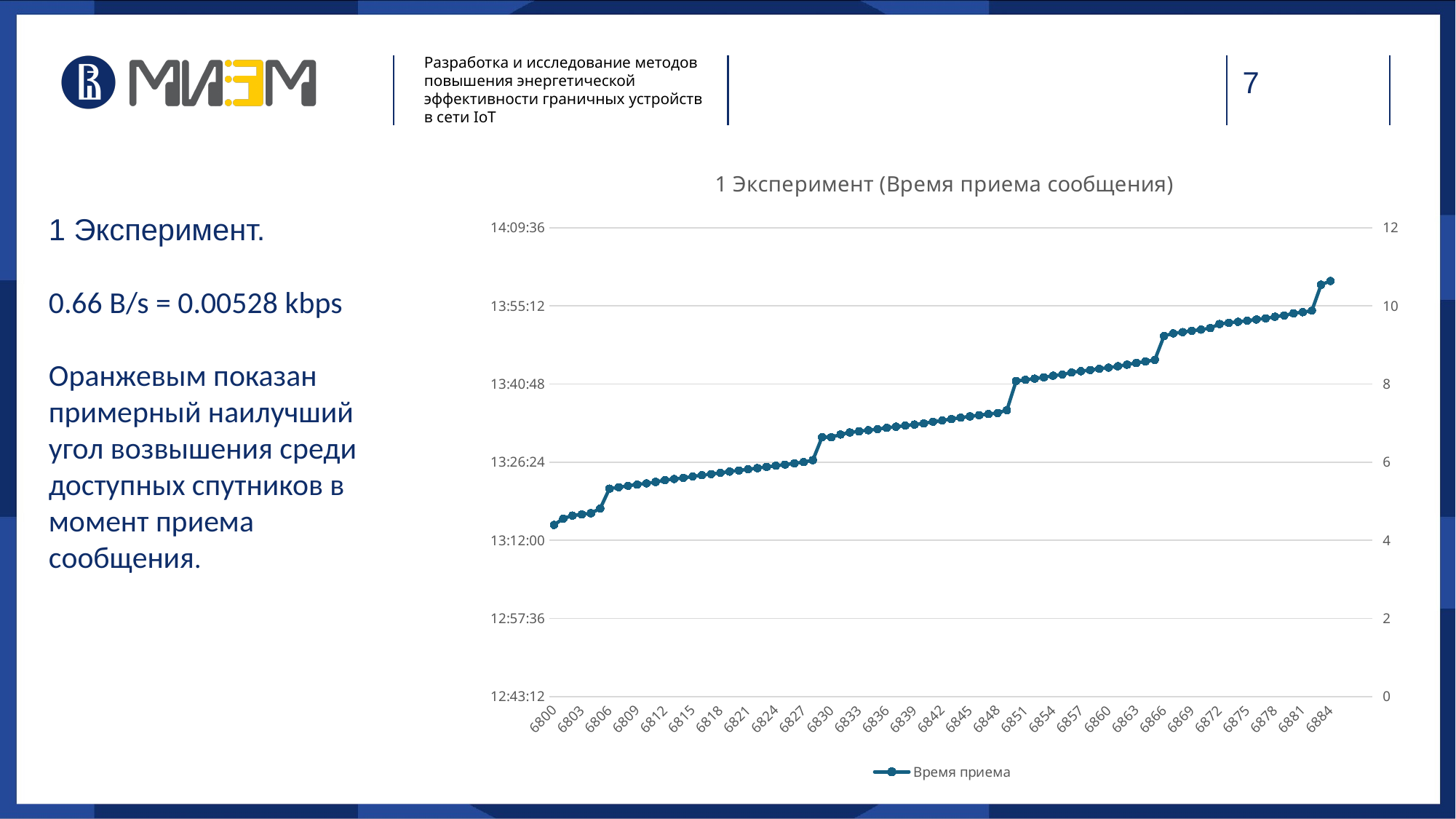
What is the name of the series shown in the legend? Время приема Is the value for 6830 greater or less than 13:26:24? greater Do the values rise or fall along the x axis from 6800 to 6884? rise Is the value for 6884 greater or less than 13:55:12? greater At which x-axis label is the plotted value lowest? 6800 Is the value for 6800 greater or less than 13:26:24? less At which x-axis label is the plotted value highest? 6884 Which has the larger value, 6815 or 6860? 6860 What is the title of the chart? 1 Эксперимент (Время приема сообщения) How many series does the chart legend list? 1 What kind of chart is shown on the slide? line chart